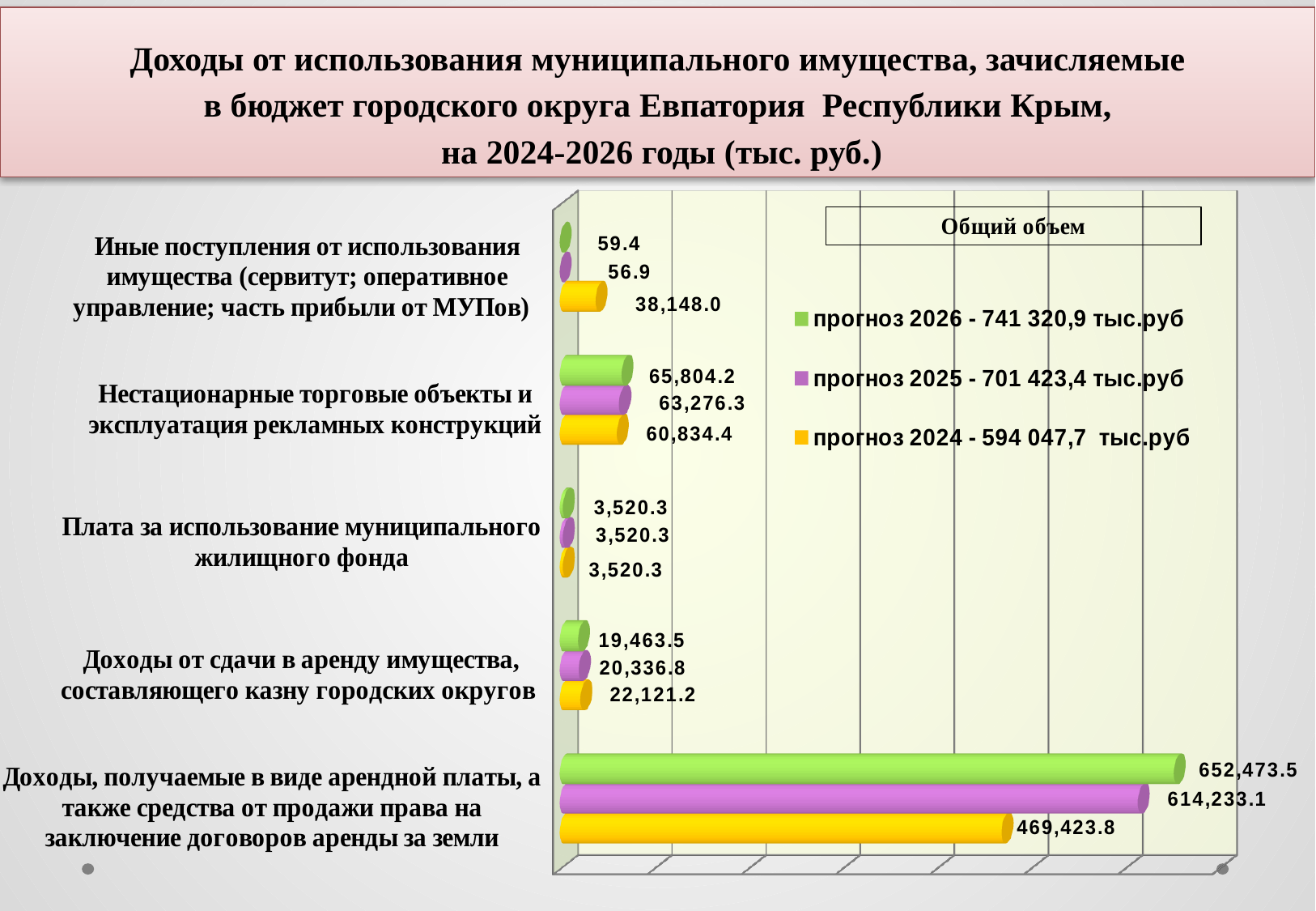
What is the 2025 forecast value for 'Доходы от сдачи в аренду имущества, составляющего казну городских округов'? 20,336.8 What is the difference between the 2026 and 2024 forecast values for 'Нестационарные торговые объекты и эксплуатация рекламных конструкций'? 4,969.8 What is the 2024 forecast value for 'Доходы, получаемые в виде арендной платы, а также средства от продажи права на заключение договоров аренды за земли'? 469,423.8 Which category has the highest 2026 forecast value? Доходы, получаемые в виде арендной платы, а также средства от продажи права на заключение договоров аренды за земли What kind of chart is shown on the slide? Bar chart How many series does the legend list? 3 What is the 2026 forecast value for 'Нестационарные торговые объекты и эксплуатация рекламных конструкций'? 65,804.2 What is the difference between the 2026 and 2024 forecast values for 'Доходы, получаемые в виде арендной платы, а также средства от продажи права на заключение договоров аренды за земли'? 183,049.7 What is the 2024 forecast value for 'Иные поступления от использования имущества (сервитут; оперативное управление; часть прибыли от МУПов)'? 38,148.0 Which category has the lowest 2025 forecast value? Иные поступления от использования имущества (сервитут; оперативное управление; часть прибыли от МУПов) How many categories are shown in the chart? 5 For 'Доходы от сдачи в аренду имущества, составляющего казну городских округов', which is larger: the 2024 forecast or the 2026 forecast? 2024 forecast